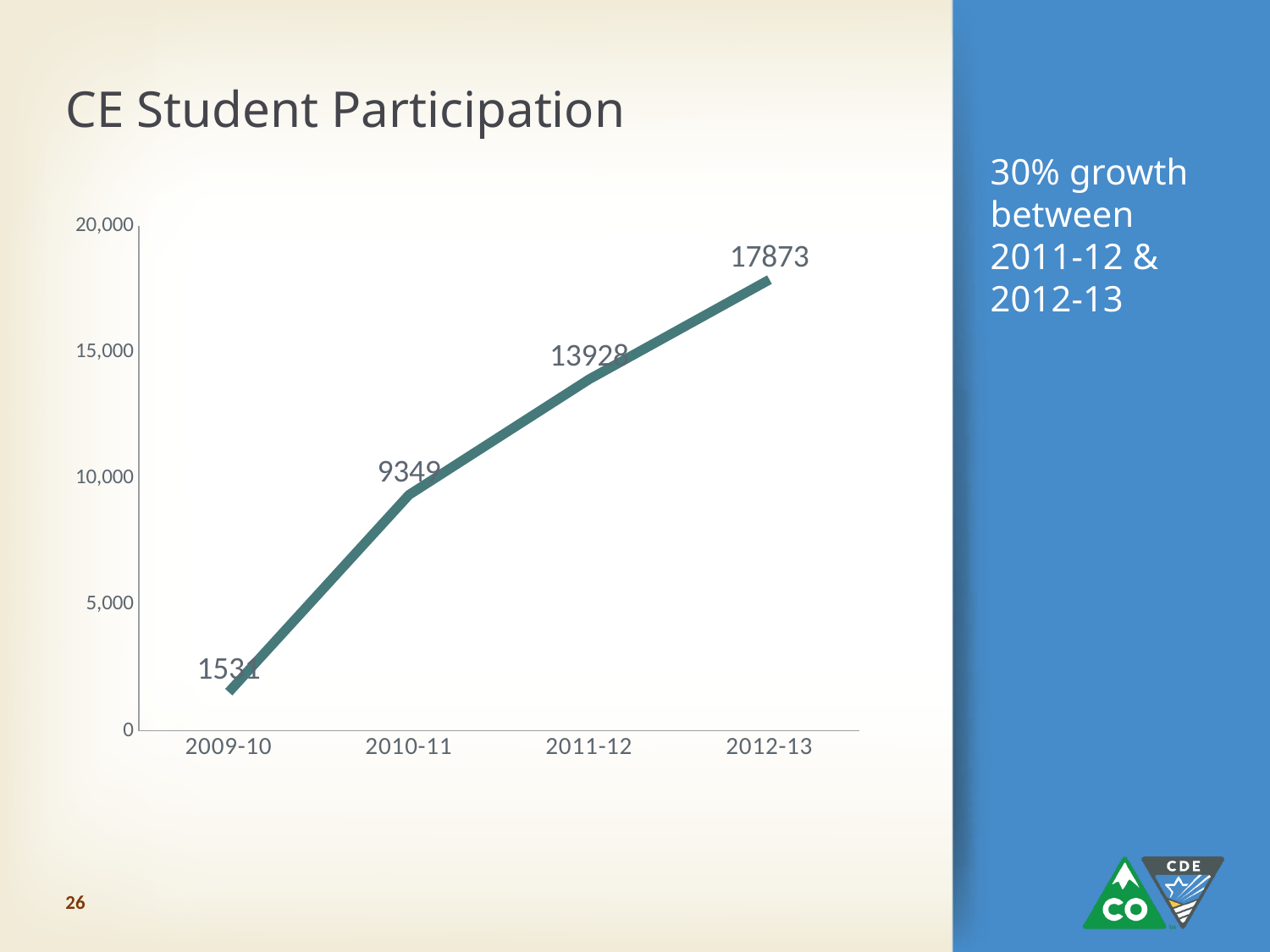
What is the difference in participation between 2012-13 and 2011-12? 3945 What kind of chart is shown on the slide? line chart What is the CE student participation value for 2010-11? 9349 Which year has the highest CE student participation? 2012-13 What is the CE student participation value for 2012-13? 17873 What is the CE student participation value for 2011-12? 13928 Which year has the lowest CE student participation? 2009-10 What is the difference in participation between 2011-12 and 2010-11? 4579 Do the values rise or fall from 2009-10 to 2012-13? rise How many years are plotted on the chart? 4 Which year has higher participation, 2010-11 or 2011-12? 2011-12 Is the value for 2009-10 greater or less than 5,000? less